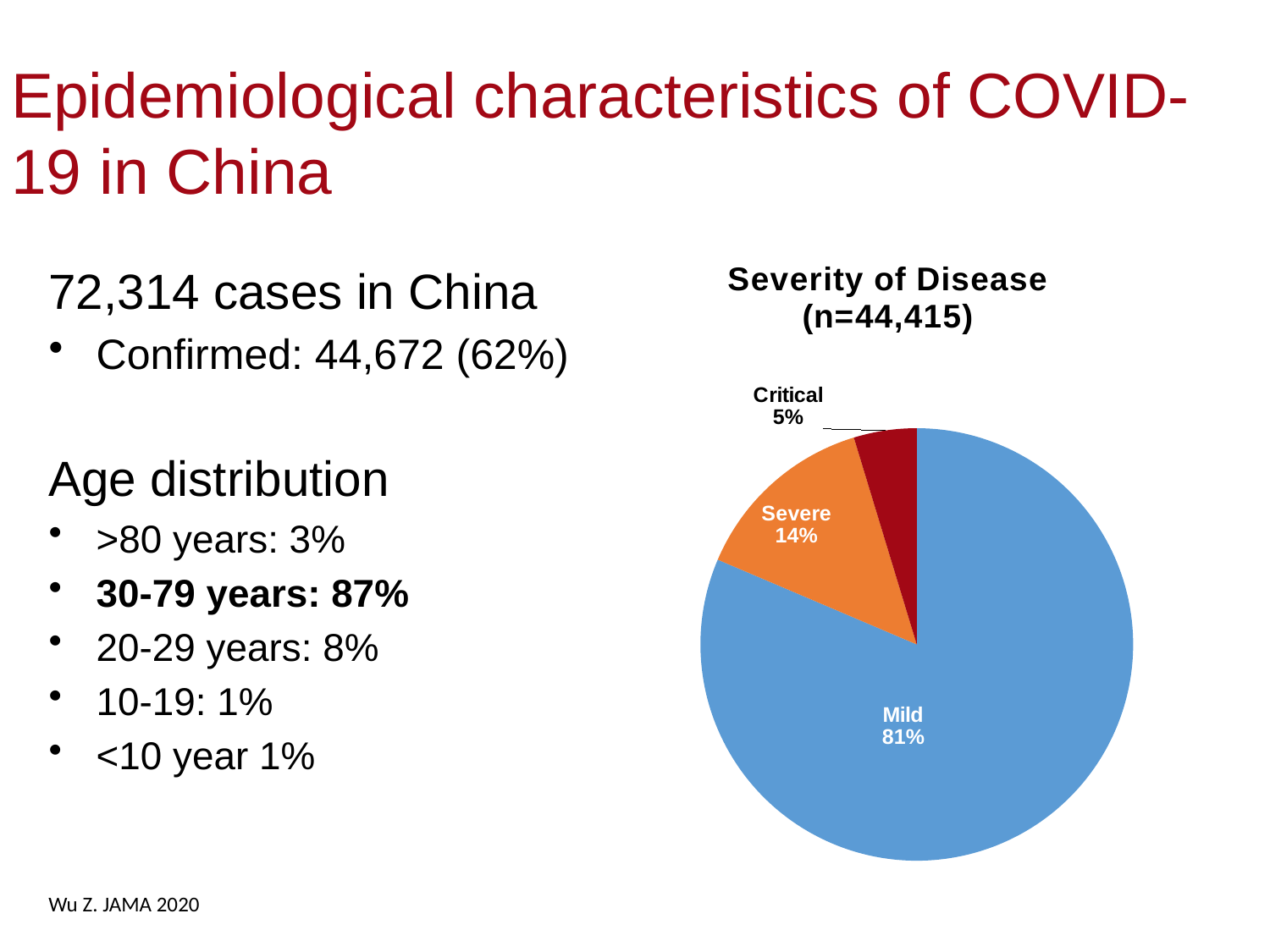
What percentage of cases are labelled Severe in the pie chart? 14% Which severity category has the largest share of the pie? Mild What is the difference in percentage points between the Mild and Severe slices? 67 Which slice is larger, Severe or Critical? Severe What is the difference in percentage points between the Severe and Critical slices? 9 Which severity category has the smallest share of the pie? Critical What is the title of the chart? Severity of Disease (n=44,415) What percentage of cases are labelled Critical in the pie chart? 5% What type of chart is shown on the slide? pie chart How many slices does the pie chart have? 3 What percentage of cases are labelled Mild in the pie chart? 81% What colour is the Mild slice of the pie chart? blue